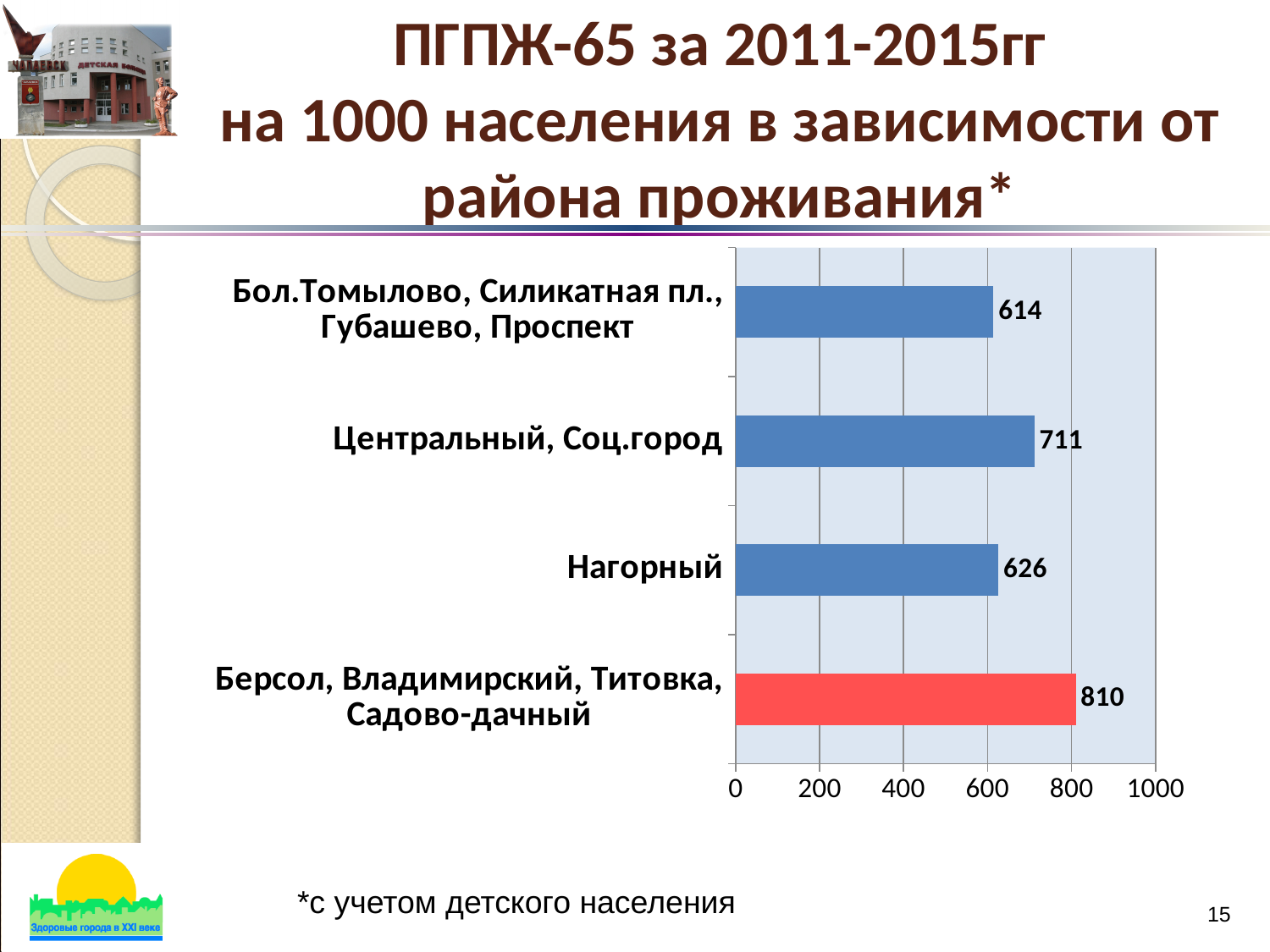
Which district has the highest value? Берсол, Владимирский, Титовка, Садово-дачный Which district has the lowest value? Бол.Томылово, Силикатная пл., Губашево, Проспект What is the value for Бол.Томылово, Силикатная пл., Губашево, Проспект? 614 What kind of chart is shown on the slide? bar chart Which is larger: the value for Центральный, Соц.город or the value for Нагорный? Центральный, Соц.город What is the difference between the values for Берсол, Владимирский, Титовка, Садово-дачный and Центральный, Соц.город? 99 How many districts are shown in the chart? 4 What is the value for Центральный, Соц.город? 711 What is the difference between the values for Нагорный and Бол.Томылово, Силикатная пл., Губашево, Проспект? 12 What is the value for Нагорный? 626 What is the value for Берсол, Владимирский, Титовка, Садово-дачный? 810 Is the value for Центральный, Соц.город greater or less than 800? less